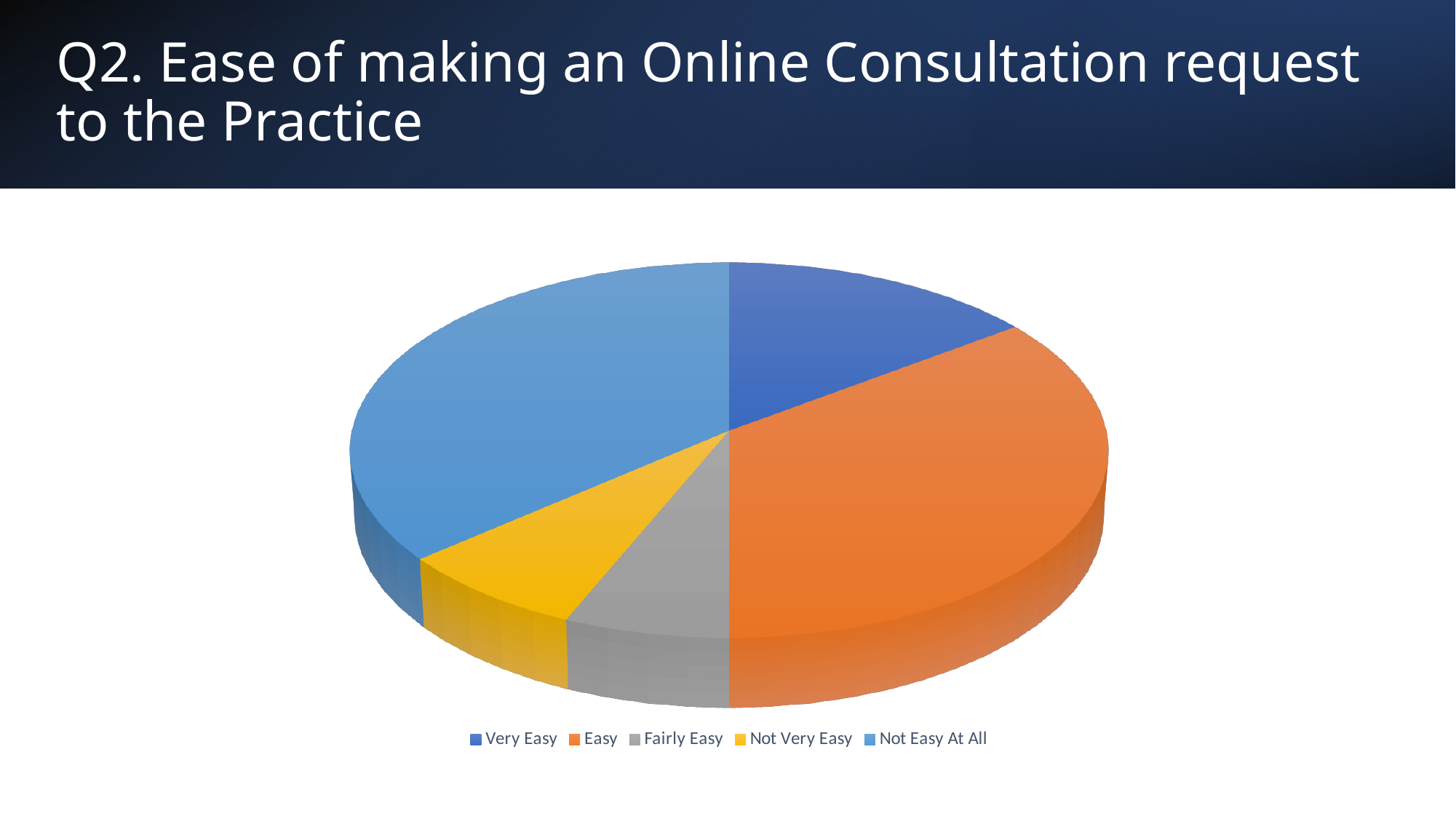
Which slice is larger, 'Very Easy' or 'Fairly Easy'? Very Easy How many categories does the pie chart show? 5 Which slice is larger, 'Not Easy At All' or 'Fairly Easy'? Not Easy At All Which slice is larger, 'Easy' or 'Not Very Easy'? Easy What kind of chart is shown on the slide? Pie chart Which colour represents the 'Easy' category in the pie chart? Orange What is the title of the slide containing the pie chart? Q2. Ease of making an Online Consultation request to the Practice